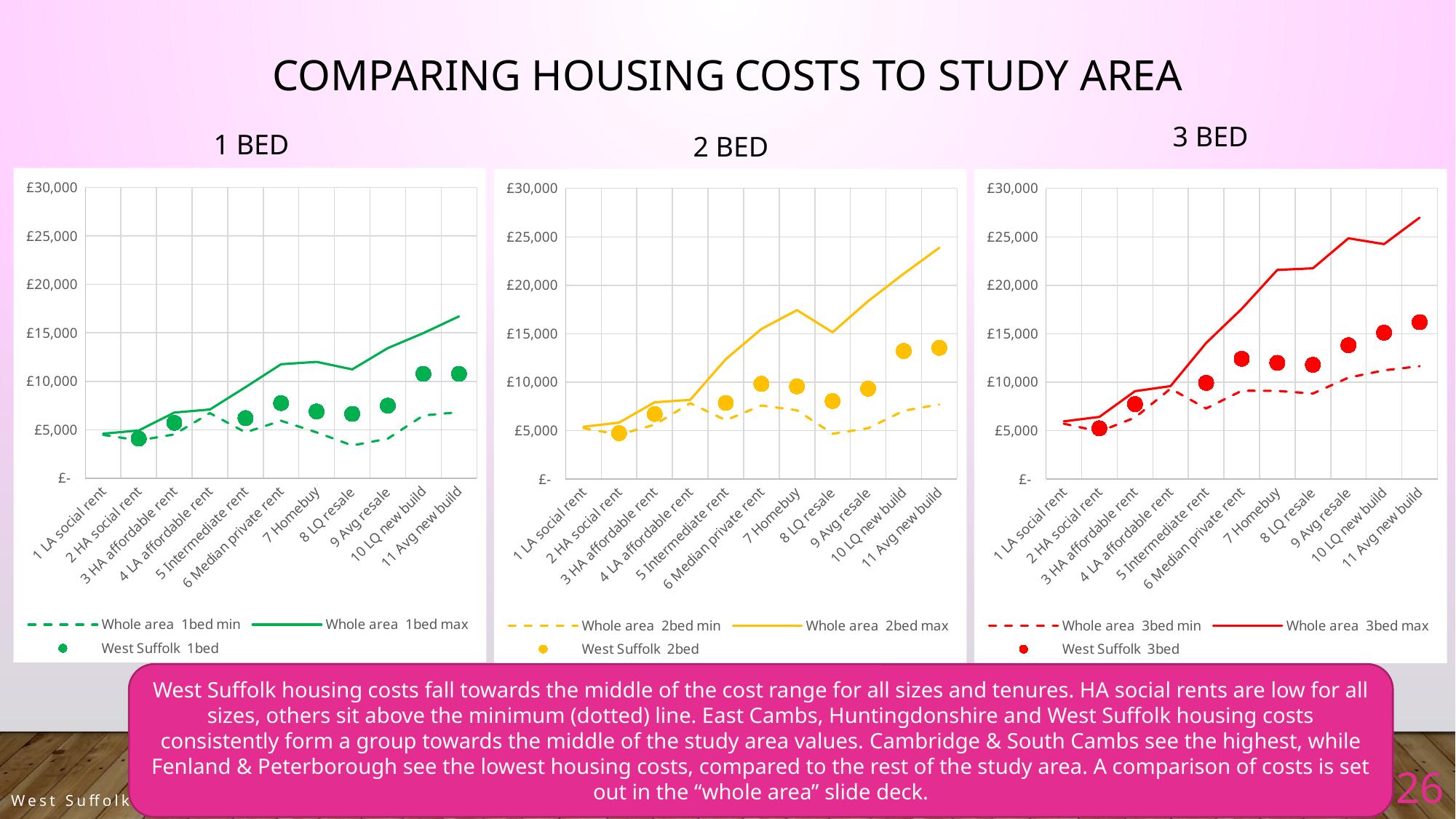
In the 1 BED chart, how many categories are shown on the x axis? 11 In the 1 BED chart, which legend entry is drawn as a dashed line? Whole area 1bed min In the 1 BED chart, which category has the lowest West Suffolk 1bed value? 2 HA social rent In the 2 BED chart, which is larger for West Suffolk 2bed: 6 Median private rent or 8 LQ resale? 6 Median private rent How many charts are on the slide? 3 In the 3 BED chart, is the Whole area 3bed max value for 11 Avg new build greater or less than £25,000? greater In the 2 BED chart, is the Whole area 2bed max value for 11 Avg new build greater or less than £20,000? greater In the 2 BED chart, how many series does the legend list? 3 In the 1 BED chart, does the Whole area 1bed max line generally rise or fall from left to right along the x axis? Rise What kind of chart is the 3 BED chart? Line chart with markers In the 3 BED chart, which category has the highest West Suffolk 3bed value? 11 Avg new build In the 1 BED chart, is the West Suffolk 1bed value for 2 HA social rent greater or less than £5,000? less